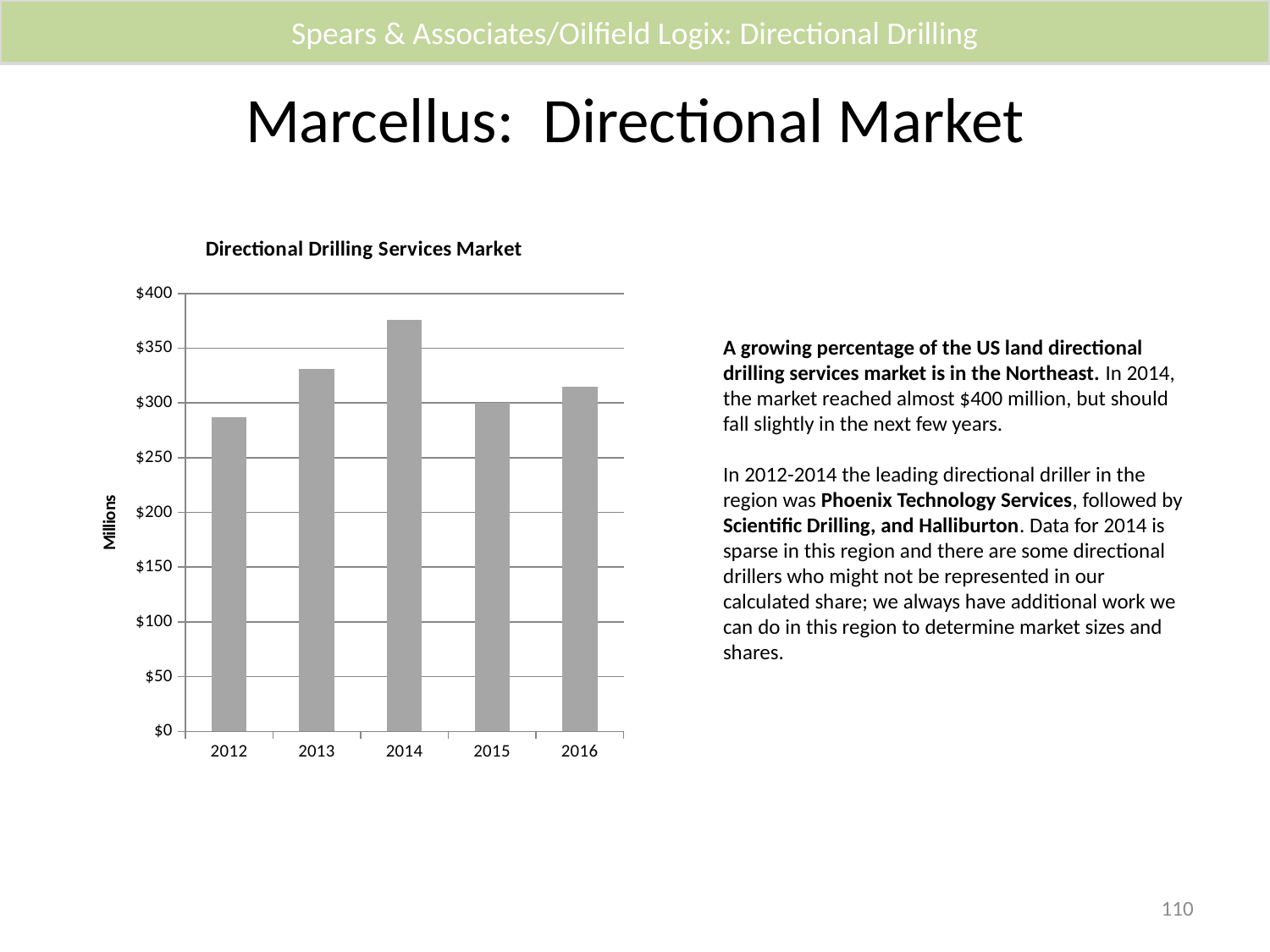
How many years are plotted on the chart? 5 Which year has the highest value on the chart? 2014 Is the value for 2012 greater or less than $300? less What kind of chart is shown on the slide? bar chart Is the value for 2013 greater or less than $350? less Which is larger, the value for 2013 or the value for 2015? 2013 Is the value for 2015 greater or less than $250? greater Which year has the lowest value on the chart? 2012 What is the title of the chart? Directional Drilling Services Market Which is larger, the value for 2014 or the value for 2016? 2014 Do the values rise or fall from 2012 to 2014? rise